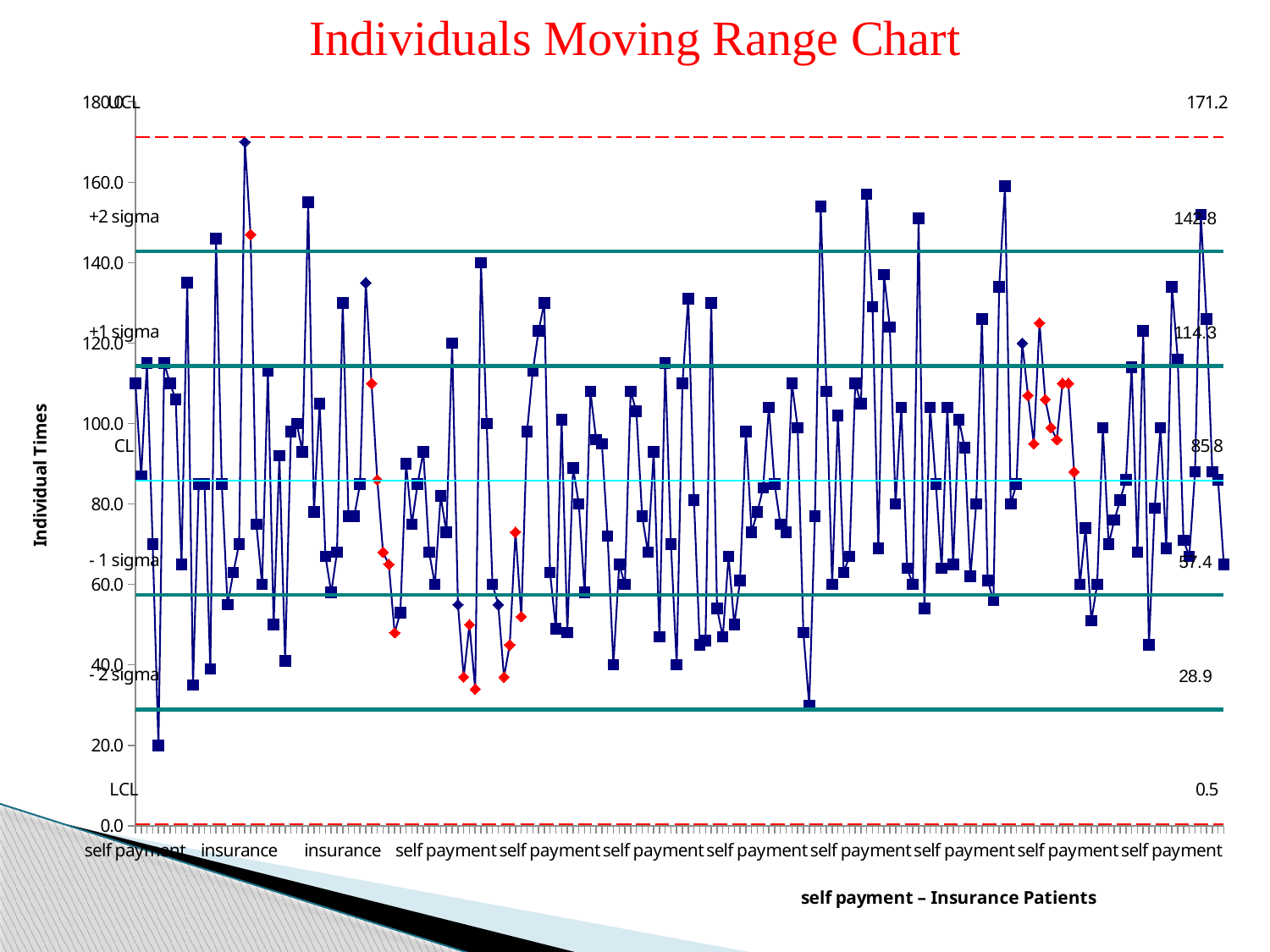
What is the difference between the +1 sigma value and the CL value? 28.5 Is the highest plotted point on the chart greater or less than 160? greater What value is printed for the +2 sigma line? 142.8 What is the value of the CL (center line) shown on the chart? 85.8 What is the label on the vertical axis of the chart? Individual Times What value is printed for the -1 sigma line? 57.4 Is the lowest plotted point on the chart greater or less than 40? less What value is printed for the -2 sigma line? 28.9 What is the value of the UCL (upper control limit) shown on the chart? 171.2 What kind of chart is shown on the slide? line chart What is the difference between the UCL and the LCL values? 170.7 What is the value of the LCL (lower control limit) shown on the chart? 0.5